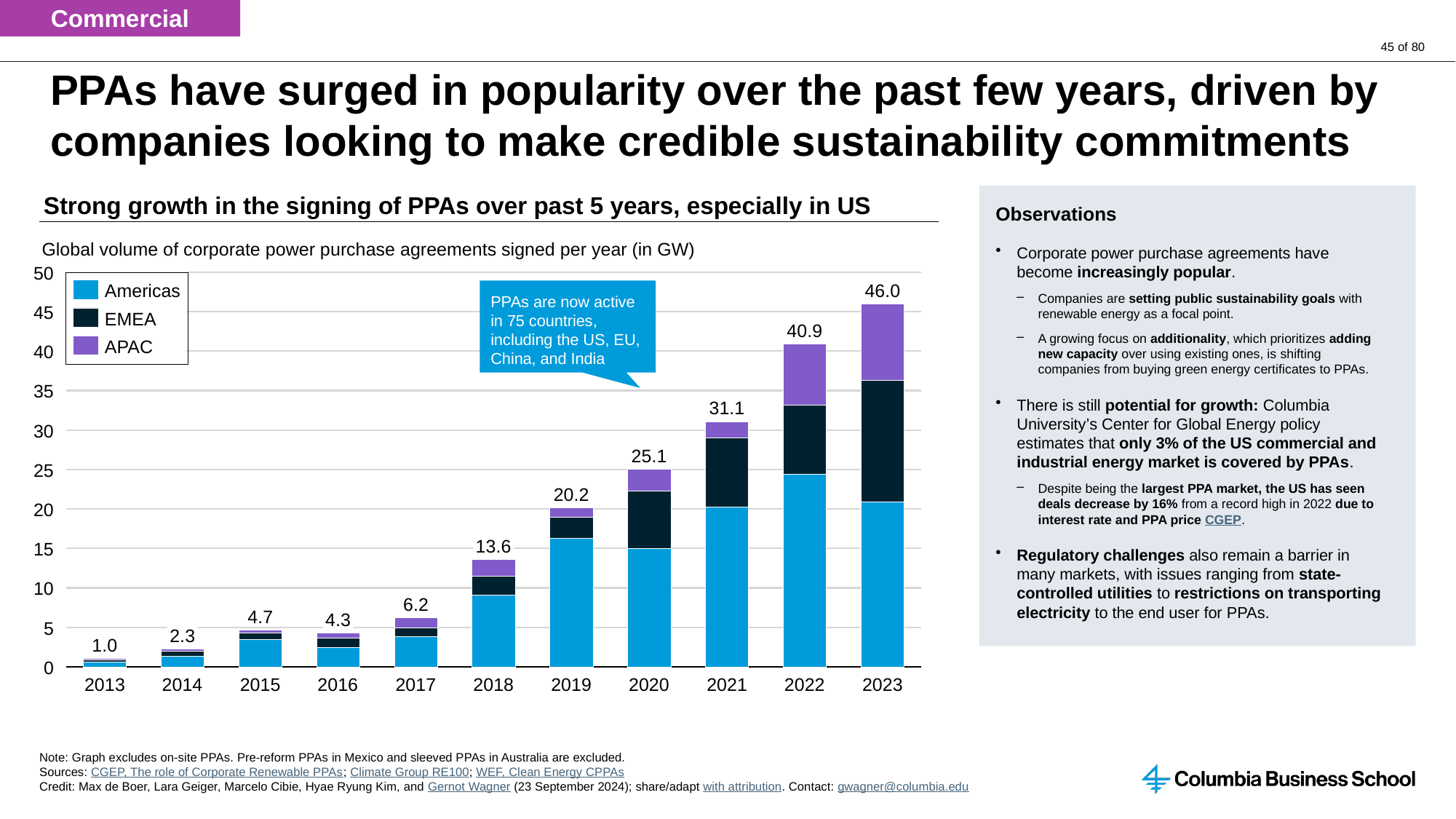
How many series does the chart's legend list? 3 Which year has the highest total volume of PPAs signed? 2023 What type of chart is used to show the global volume of corporate PPAs? Stacked bar chart What is the total global volume of corporate PPAs signed in 2023 according to the chart? 46.0 What total value is labeled above the 2018 bar? 13.6 Which year has the lowest total volume of PPAs signed? 2013 By how much did the total volume increase from 2022 to 2023? 5.1 Is the Americas value for 2022 greater or less than 20? greater Do the total volumes generally rise or fall from 2013 to 2023? Rise Which year had a larger total volume, 2015 or 2016? 2015 How many years are shown on the x axis of the chart? 11 Which region is represented by the purple segments in the chart? APAC